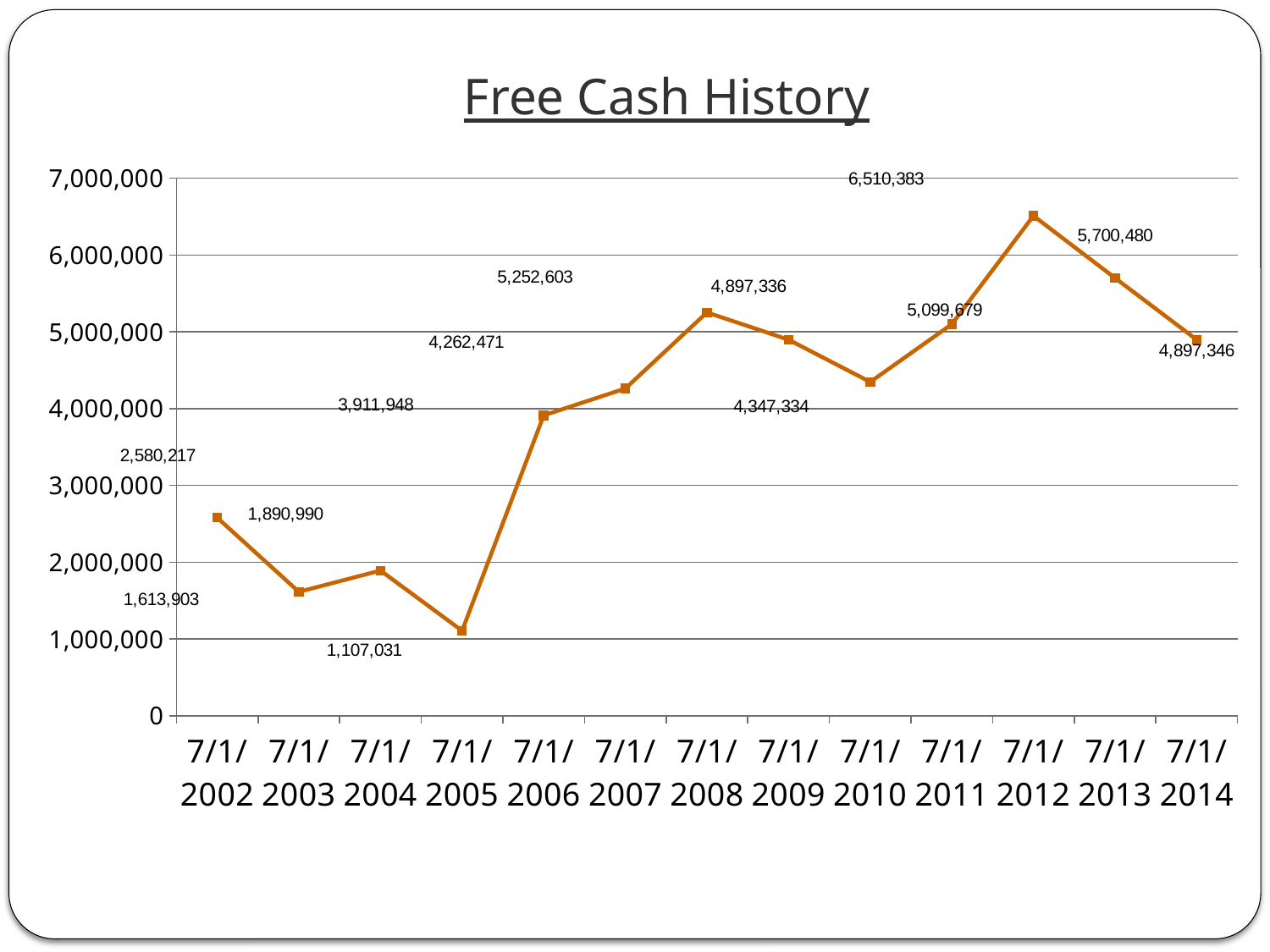
Which date has the lowest free cash value? 7/1/2005 Does the free cash value rise or fall from 7/1/2012 to 7/1/2014? fall What is the free cash value for 7/1/2008? 5,252,603 Which is larger, the free cash value for 7/1/2002 or for 7/1/2006? 7/1/2006 What is the title of the chart? Free Cash History What is the free cash value for 7/1/2012? 6,510,383 What is the free cash value for 7/1/2005? 1,107,031 What type of chart is shown on the slide? line chart Which date has the highest free cash value? 7/1/2012 What is the free cash value for 7/1/2014? 4,897,346 How many data points are plotted on the chart? 13 What is the difference between the free cash values for 7/1/2012 and 7/1/2013? 809,903